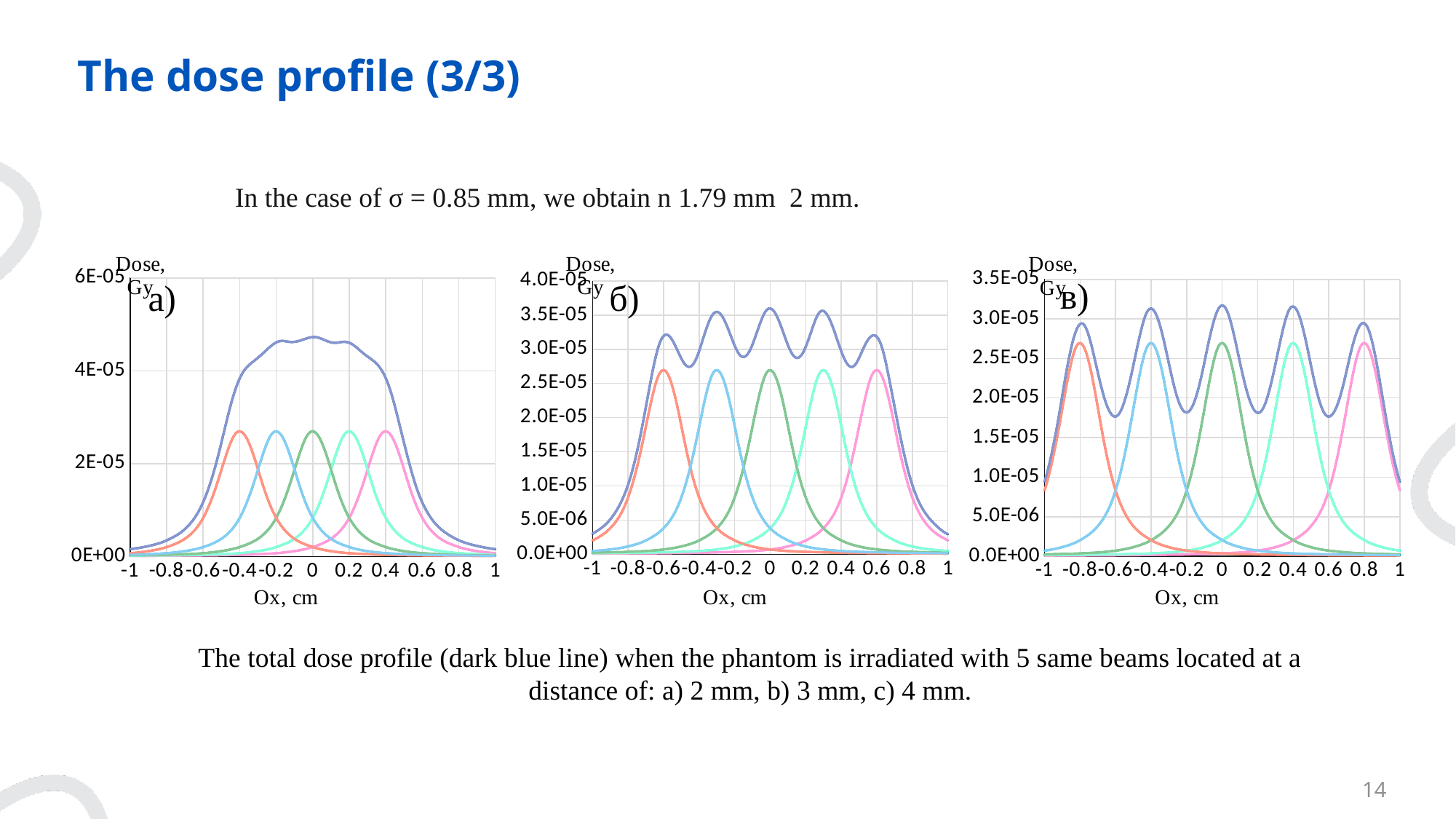
In chart a), is the peak value of the dark blue total dose line greater or less than 4E-05? greater In chart б) (middle), is the highest value of the dark blue total dose line greater or less than 3.0E-05? greater In chart б) (middle), is the peak of the green line greater or less than 3.0E-05? less How many peaks does the dark blue total dose line have in chart в) (right)? 5 How many lines are plotted in chart б) (middle)? 6 What kind of chart is chart a) on the left? line chart In chart a), does the dark blue line rise or fall as Ox goes from 0.4 to 1? fall What is the x-axis title of the charts? Ox, cm What is the y-axis title of the charts? Dose, Gy